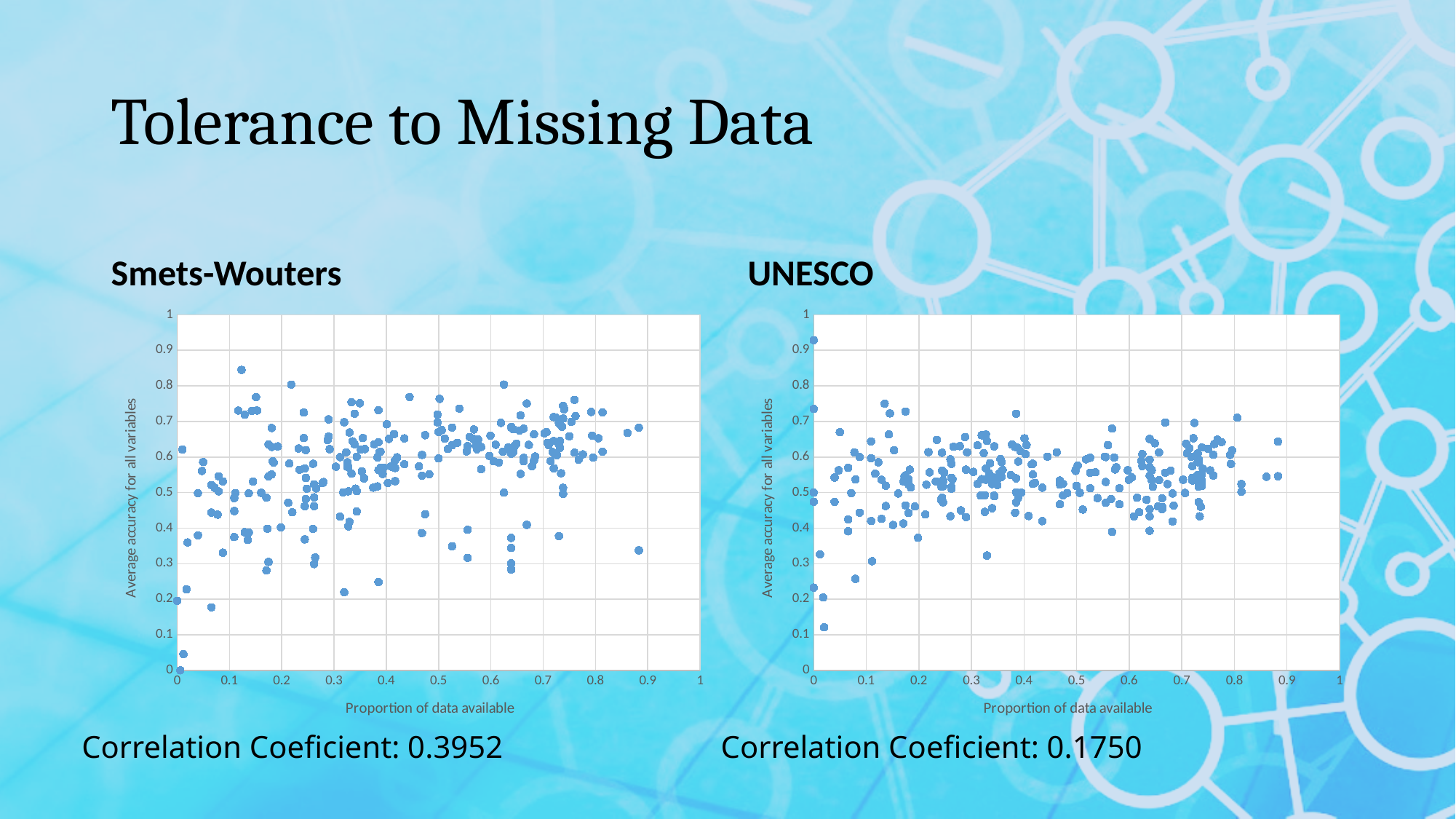
What kind of chart is the UNESCO chart? scatter chart What kind of chart is the Smets-Wouters chart? scatter chart What is the maximum value shown on the y axis of the Smets-Wouters chart? 1 In the Smets-Wouters chart, does average accuracy generally rise or fall as the proportion of data available increases? rise What is the x-axis title of the Smets-Wouters chart? Proportion of data available In the Smets-Wouters chart, is the lowest plotted point greater or less than 0.1 on the y axis? less What is the maximum value shown on the x axis of the UNESCO chart? 1 What is the y-axis title of the UNESCO chart? Average accuracy for all variables In the Smets-Wouters chart, is the highest plotted point greater or less than 0.8 on the y axis? greater In the UNESCO chart, is the highest plotted point greater or less than 0.9 on the y axis? greater How many charts are shown on the slide? 2